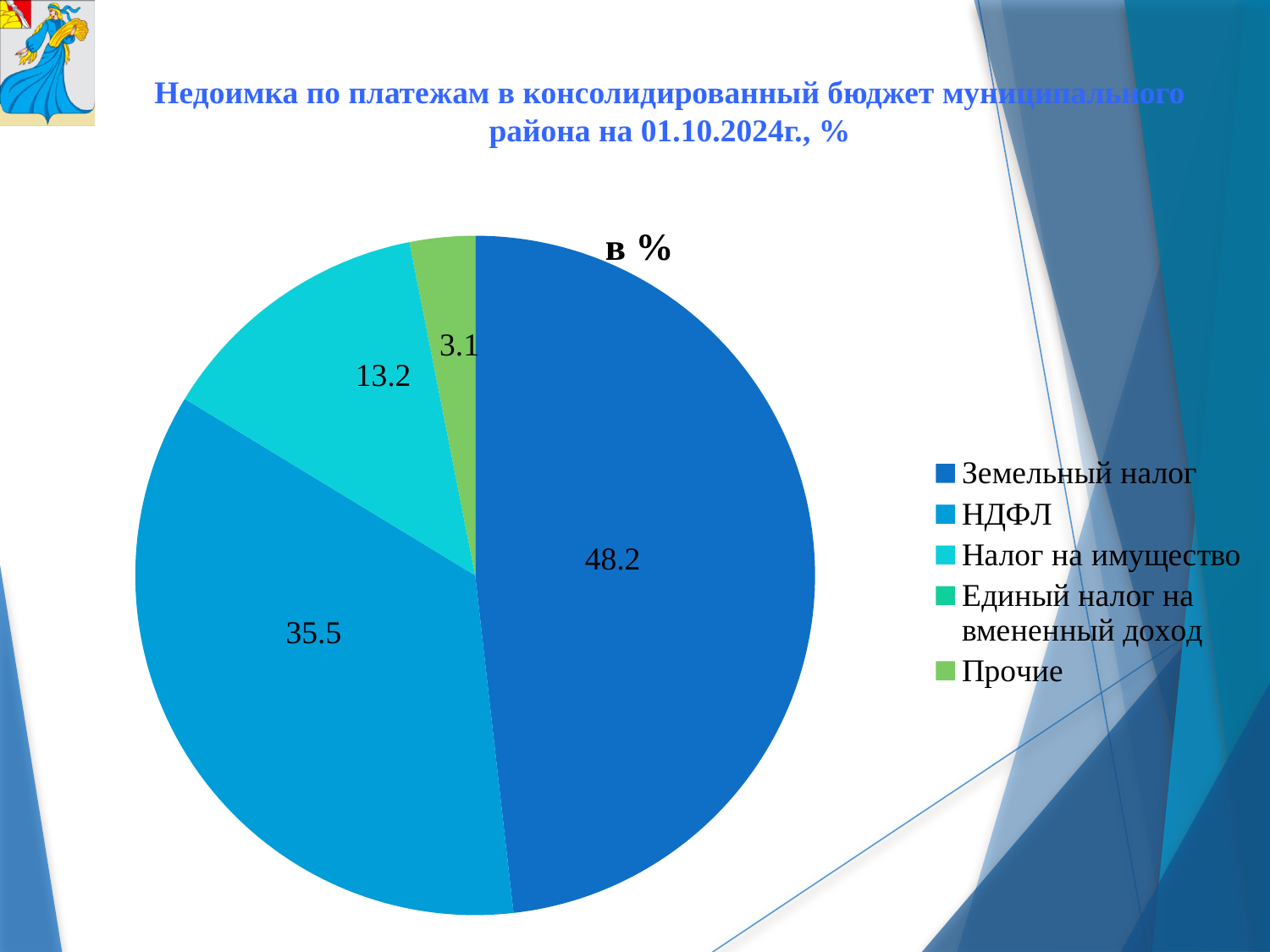
What is the value for Земельный налог? 48.2 What is the difference between the values for Земельный налог and НДФЛ? 12.7 What is the value for НДФЛ? 35.5 Which labelled slice is the smallest? Прочие What is the title shown above the pie chart? в % How many entries does the legend list? 5 Which is larger, the value for Налог на имущество or the value for Прочие? Налог на имущество Which category has the largest slice of the pie? Земельный налог What type of chart is shown on the slide? pie chart What is the value for Налог на имущество? 13.2 What is the difference between the values for НДФЛ and Налог на имущество? 22.3 What is the value for Прочие? 3.1